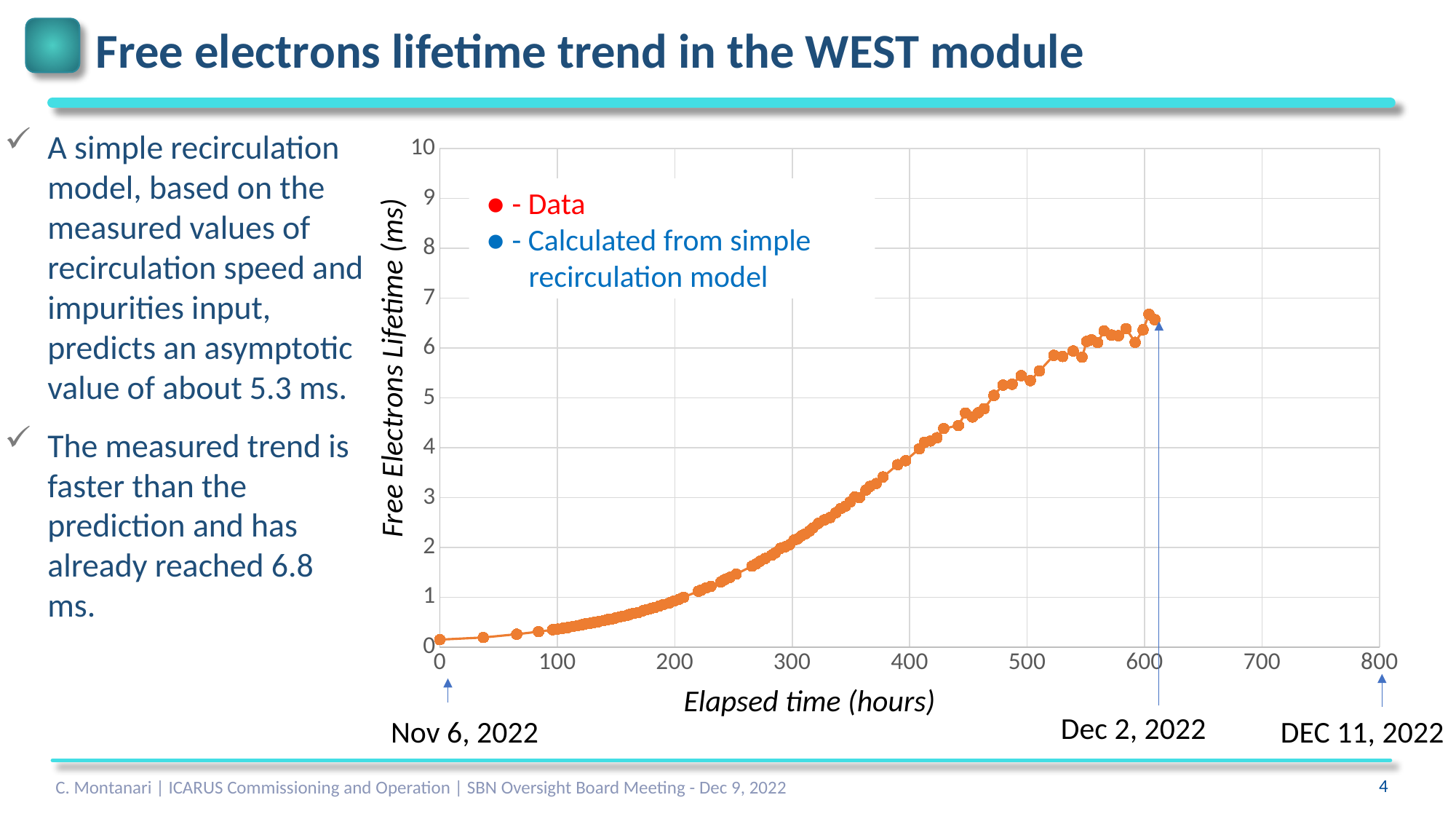
Is the free electrons lifetime at 600 hours greater or less than 6 ms? greater What kind of chart is shown on the slide? Scatter chart Is the free electrons lifetime at 100 hours greater or less than 1 ms? less Is the free electrons lifetime at 300 hours greater or less than 3 ms? less Do the plotted values rise or fall as elapsed time increases? Rise How many series does the legend list? 2 Which date is annotated at 800 hours on the x axis? DEC 11, 2022 What is the title of the vertical axis? Free Electrons Lifetime (ms)